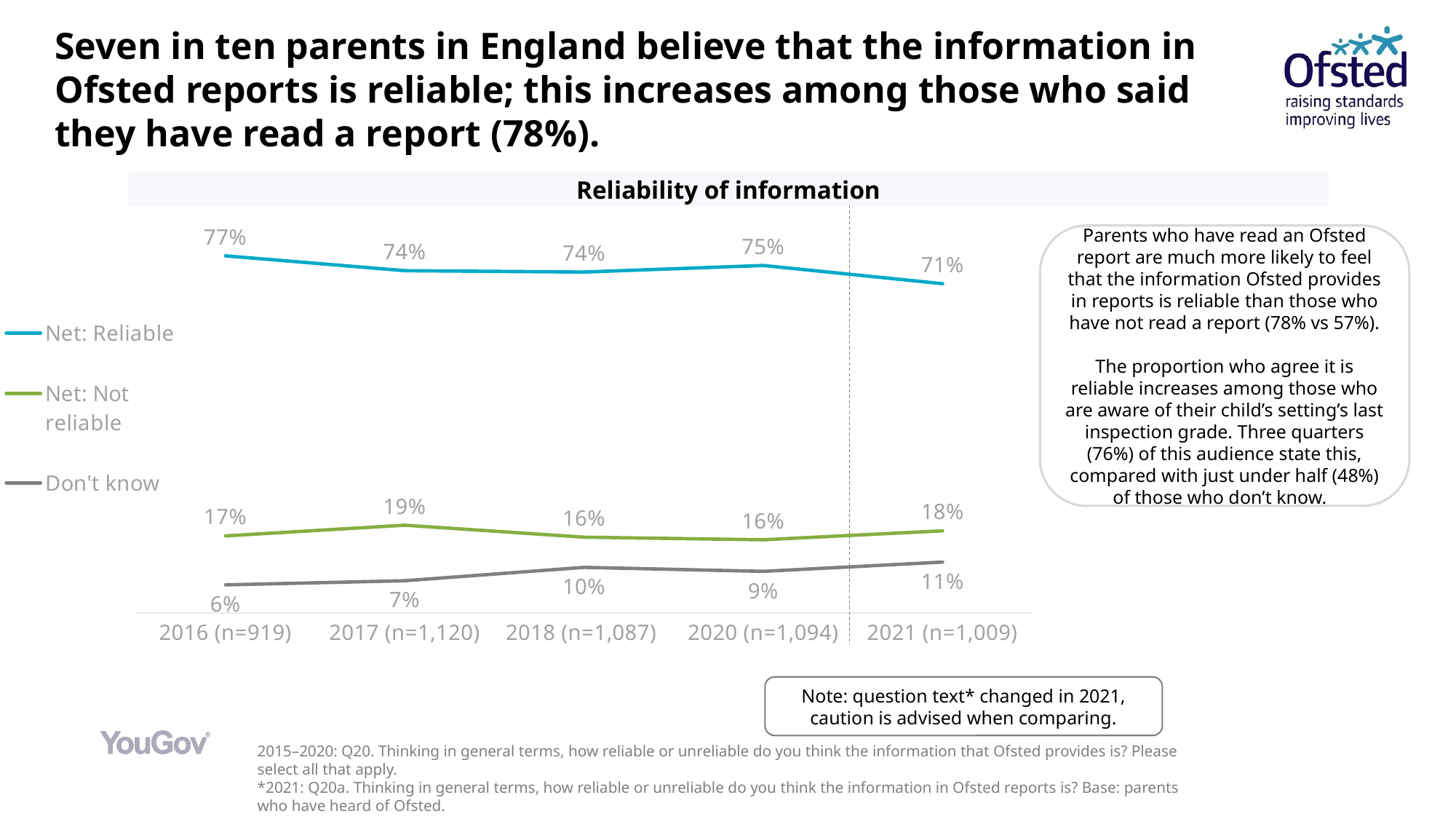
How many series does the legend list? 3 What is the difference between the Net: Reliable values in 2016 and 2021? 6 percentage points Which is larger: Net: Not reliable in 2018 or Don't know in 2018? Net: Not reliable How many time points are plotted on the x axis? 5 In which year is the Don't know value highest? 2021 (n=1,009) What kind of chart is shown? Line chart What is the value for Net: Not reliable in 2017 (n=1,120)? 19% What is the value for Don't know in 2021 (n=1,009)? 11% What is the title of the chart? Reliability of information What is the value for Net: Reliable in 2016 (n=919)? 77% Does the Don't know series generally rise or fall from 2016 to 2021? Rise In which year is the Net: Reliable value lowest? 2021 (n=1,009)